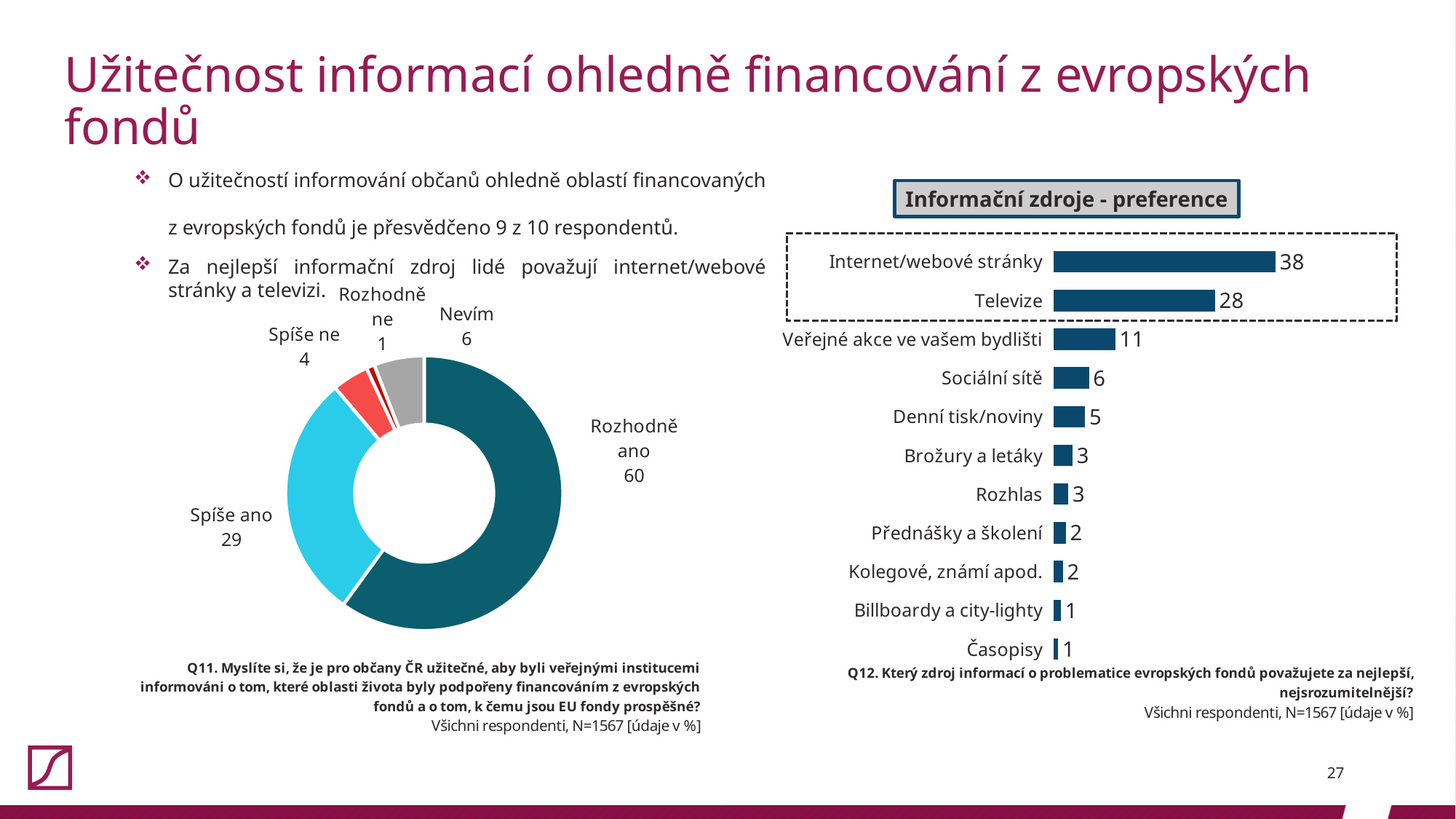
In the donut chart on the left, what is the value for Spíše ano? 29 In the 'Informační zdroje - preference' bar chart, what is the difference between Internet/webové stránky and Televize? 10 In the 'Informační zdroje - preference' bar chart, what is the value for Televize? 28 In the 'Informační zdroje - preference' bar chart, what is the value for Veřejné akce ve vašem bydlišti? 11 In the donut chart on the left, which category has the smallest share? Rozhodně ne In the donut chart on the left, what is the difference between Rozhodně ano and Spíše ano? 31 How many categories are shown in the donut chart on the left? 5 In the 'Informační zdroje - preference' bar chart, which category has the highest value? Internet/webové stránky What kind of chart is the chart on the left of the slide? Donut chart What kind of chart is the 'Informační zdroje - preference' chart on the right? Bar chart How many categories are shown in the 'Informační zdroje - preference' bar chart? 11 In the 'Informační zdroje - preference' bar chart, which is larger: Sociální sítě or Denní tisk/noviny? Sociální sítě